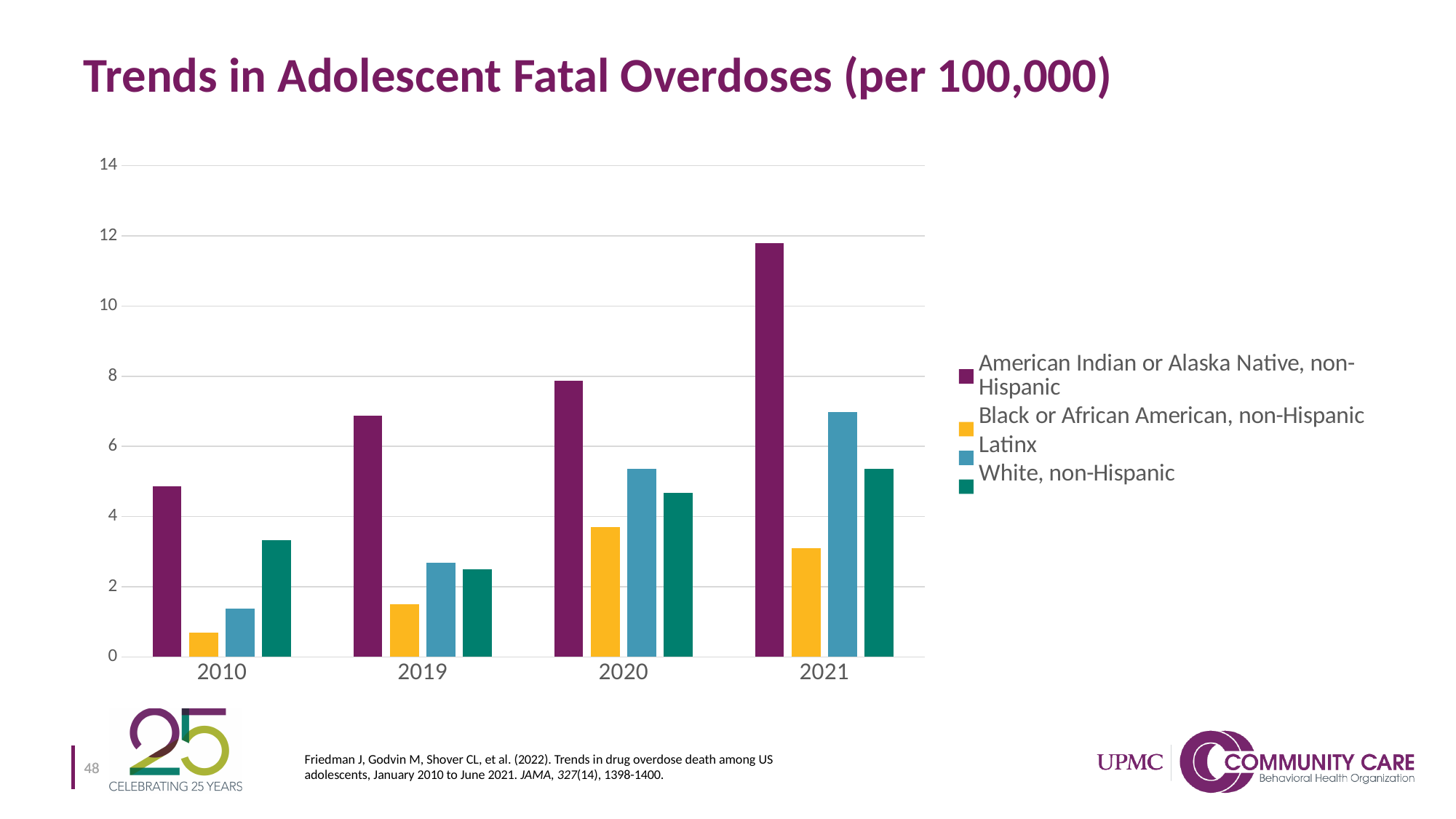
How many years are shown on the x axis? 4 What kind of chart is shown on the slide? bar chart Is the value for Latinx in 2021 greater or less than 6? greater Is the value for American Indian or Alaska Native, non-Hispanic in 2021 greater or less than 10? greater In which year is the value for American Indian or Alaska Native, non-Hispanic highest? 2021 How many series does the legend list? 4 Which group has the lowest value in 2010? Black or African American, non-Hispanic Does the value for American Indian or Alaska Native, non-Hispanic rise or fall from 2010 to 2021? rise Which group has the highest value in 2021? American Indian or Alaska Native, non-Hispanic Is the value for Black or African American, non-Hispanic in 2010 greater or less than 2? less In 2021, which is larger: the value for Latinx or the value for White, non-Hispanic? Latinx